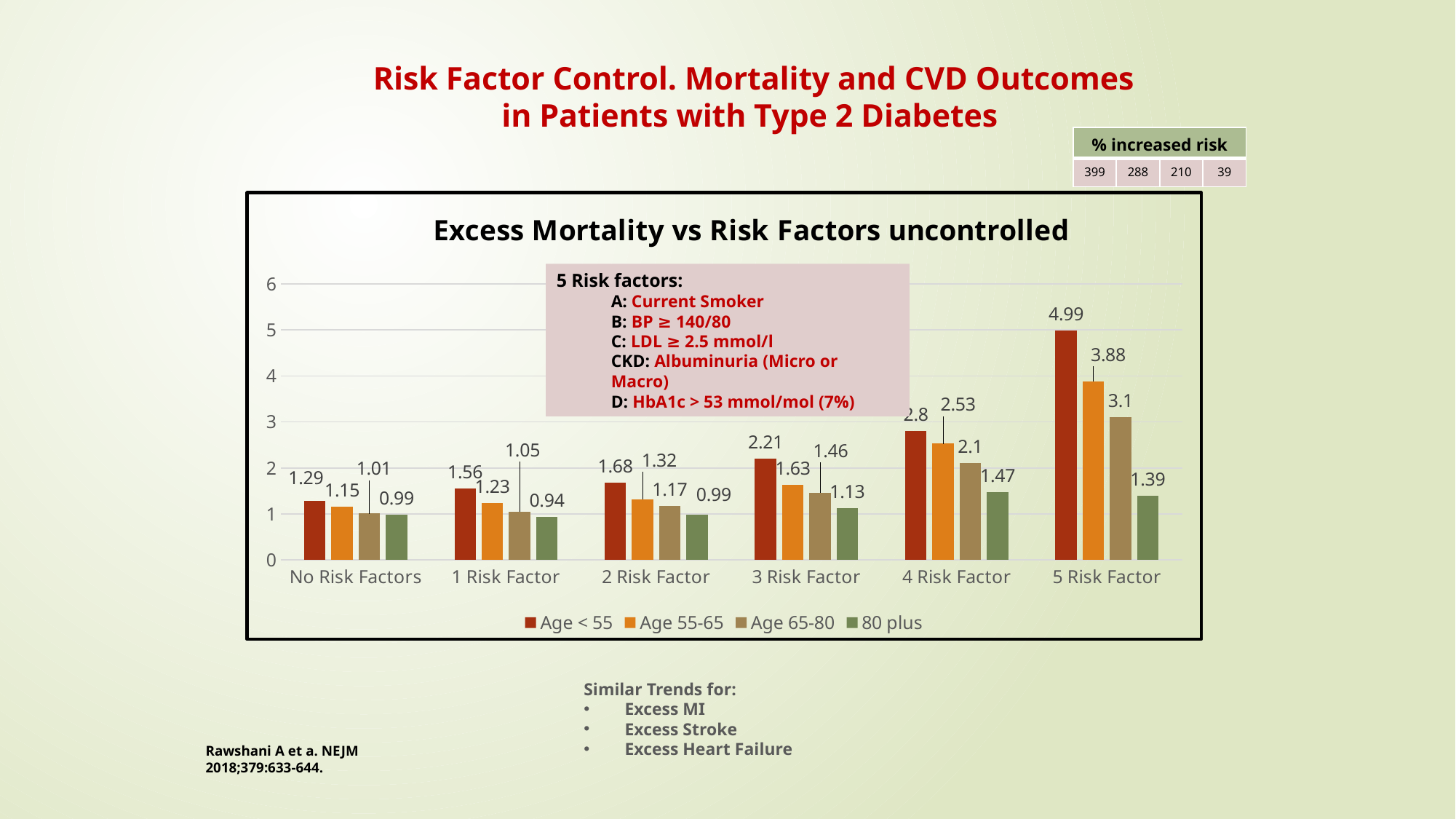
What is the value for Age 55-65 at 4 Risk Factor? 2.53 Which category has the lowest value for the 80 plus series? 1 Risk Factor What is the value for Age 65-80 at 3 Risk Factor? 1.46 What kind of chart is shown? Bar chart Which category has the highest value for the Age < 55 series? 5 Risk Factor How many series does the legend list? 4 What is the value for Age < 55 at 5 Risk Factor? 4.99 Does the Age < 55 series rise or fall as the number of risk factors increases? Rises What is the difference between the Age < 55 and Age 55-65 values at 5 Risk Factor? 1.11 What is the value for 80 plus at No Risk Factors? 0.99 How many categories are shown on the x axis? 6 Which is larger at 2 Risk Factor: the Age 55-65 value or the Age 65-80 value? Age 55-65